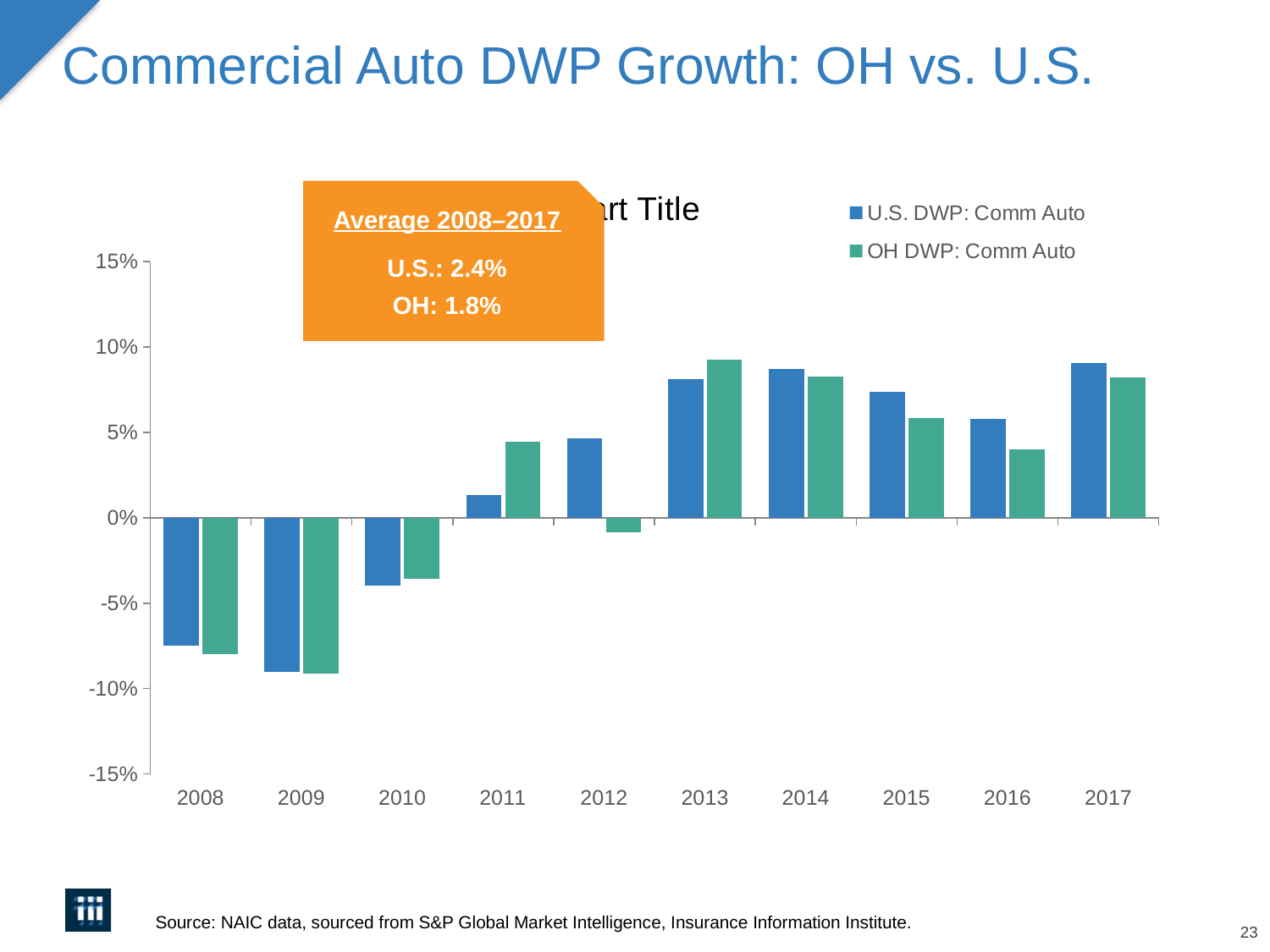
Do the U.S. DWP: Comm Auto values rise or fall from 2008 to 2013? Rise How many series does the legend list? 2 Which year has the lowest value for U.S. DWP: Comm Auto? 2009 How many years are shown on the x axis? 10 Which year has the highest value for OH DWP: Comm Auto? 2013 In 2011, which is larger: U.S. DWP: Comm Auto or OH DWP: Comm Auto? OH DWP: Comm Auto What kind of chart is shown on the slide? Bar chart Is the value for OH DWP: Comm Auto in 2012 greater or less than 0%? less In 2012, which is larger: U.S. DWP: Comm Auto or OH DWP: Comm Auto? U.S. DWP: Comm Auto Is the value for OH DWP: Comm Auto in 2013 greater or less than 5%? greater According to the text box, what is the U.S. average for 2008–2017? 2.4% Is the value for U.S. DWP: Comm Auto in 2008 greater or less than -5%? less